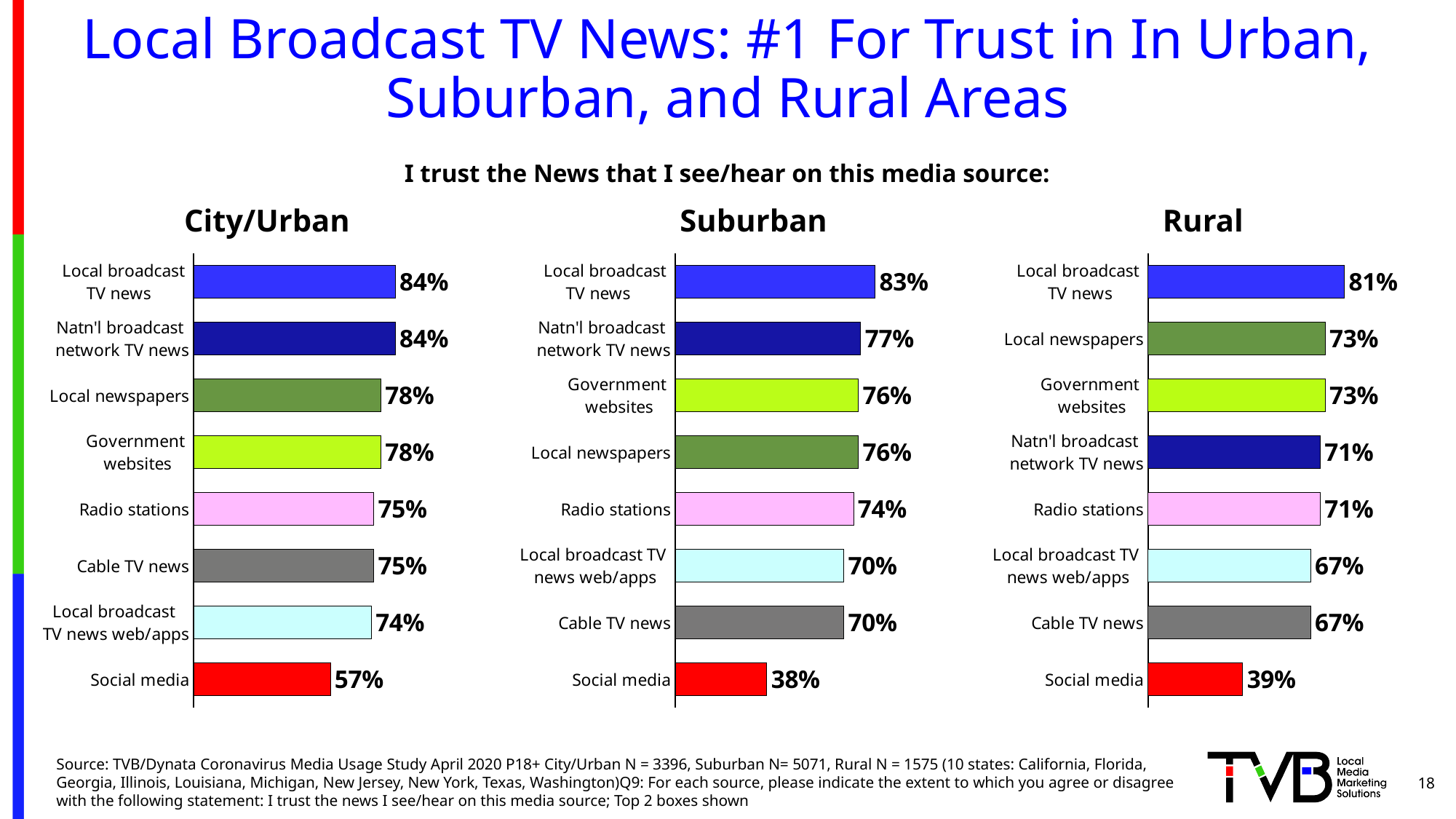
In the Suburban chart, which category has the highest value? Local broadcast TV news How many categories are shown in the Suburban chart? 8 In the Rural chart, what is the value for Local broadcast TV news? 81% In the City/Urban chart, what is the value for Local newspapers? 78% In the Rural chart, which category has the lowest value? Social media How many charts are shown on the slide? 3 In the City/Urban chart, what colour is the Social media bar? red In the Suburban chart, what is the value for Social media? 38% In the City/Urban chart, what is the difference between Local broadcast TV news and Social media? 27% In the Suburban chart, which is larger: Natn'l broadcast network TV news or Radio stations? Natn'l broadcast network TV news In the Rural chart, what is the difference between Local newspapers and Cable TV news? 6% What type of chart is the Rural chart? bar chart